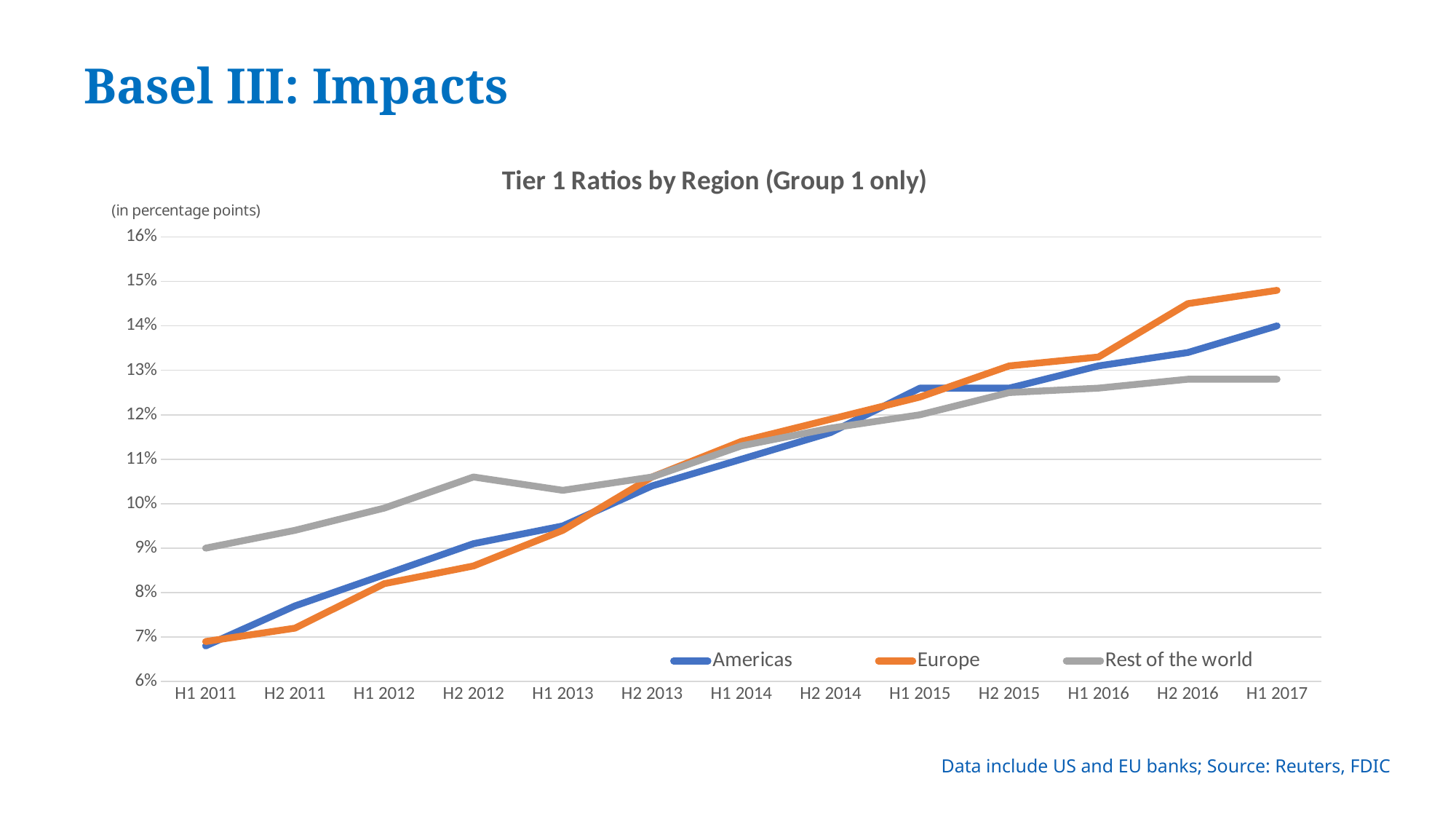
How many series does the legend list? 3 Does the Europe line rise or fall from H1 2011 to H1 2017? rise Is the value for Europe at H1 2017 greater or less than 14%? greater Is the value for Europe at H2 2011 greater or less than 8%? less How many periods are shown along the x axis? 13 Is the value for Rest of the world at H1 2017 greater or less than 13%? less At H1 2012, which is larger: Rest of the world or Europe? Rest of the world At H1 2017, which is larger: Europe or Rest of the world? Europe Which region has the lowest value at H1 2017? Rest of the world Which region has the highest value at H2 2012? Rest of the world What is the title of the chart? Tier 1 Ratios by Region (Group 1 only) What kind of chart is shown on the slide? line chart